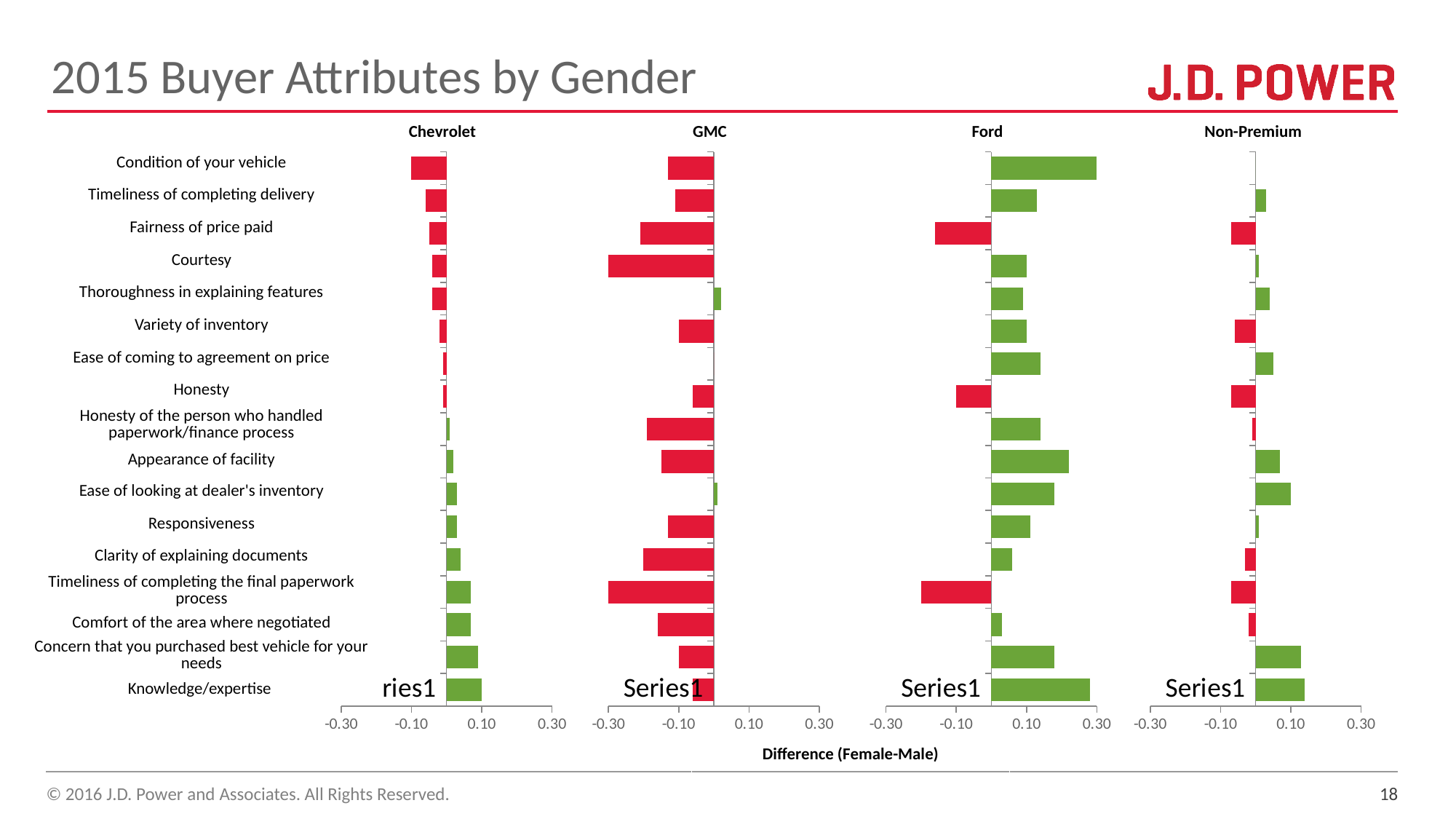
What is the x-axis title shown beneath the charts? Difference (Female-Male) In the Ford chart, is the value for Knowledge/expertise greater or less than 0.10? greater In the GMC chart, is the value for Fairness of price paid greater or less than -0.10? less How many attribute categories are listed on the slide's charts? 17 In the Non-Premium chart, is the value for Knowledge/expertise greater or less than 0.10? greater In the Chevrolet chart, which attribute has the lowest (most negative) value? Condition of your vehicle How many separate charts (brand panels) are shown on the slide? 4 In the GMC chart, which is larger: the value for Thoroughness in explaining features or the value for Courtesy? Thoroughness in explaining features What kind of chart is used for the Chevrolet panel? bar chart In the Ford chart, which is larger: the value for Condition of your vehicle or the value for Clarity of explaining documents? Condition of your vehicle